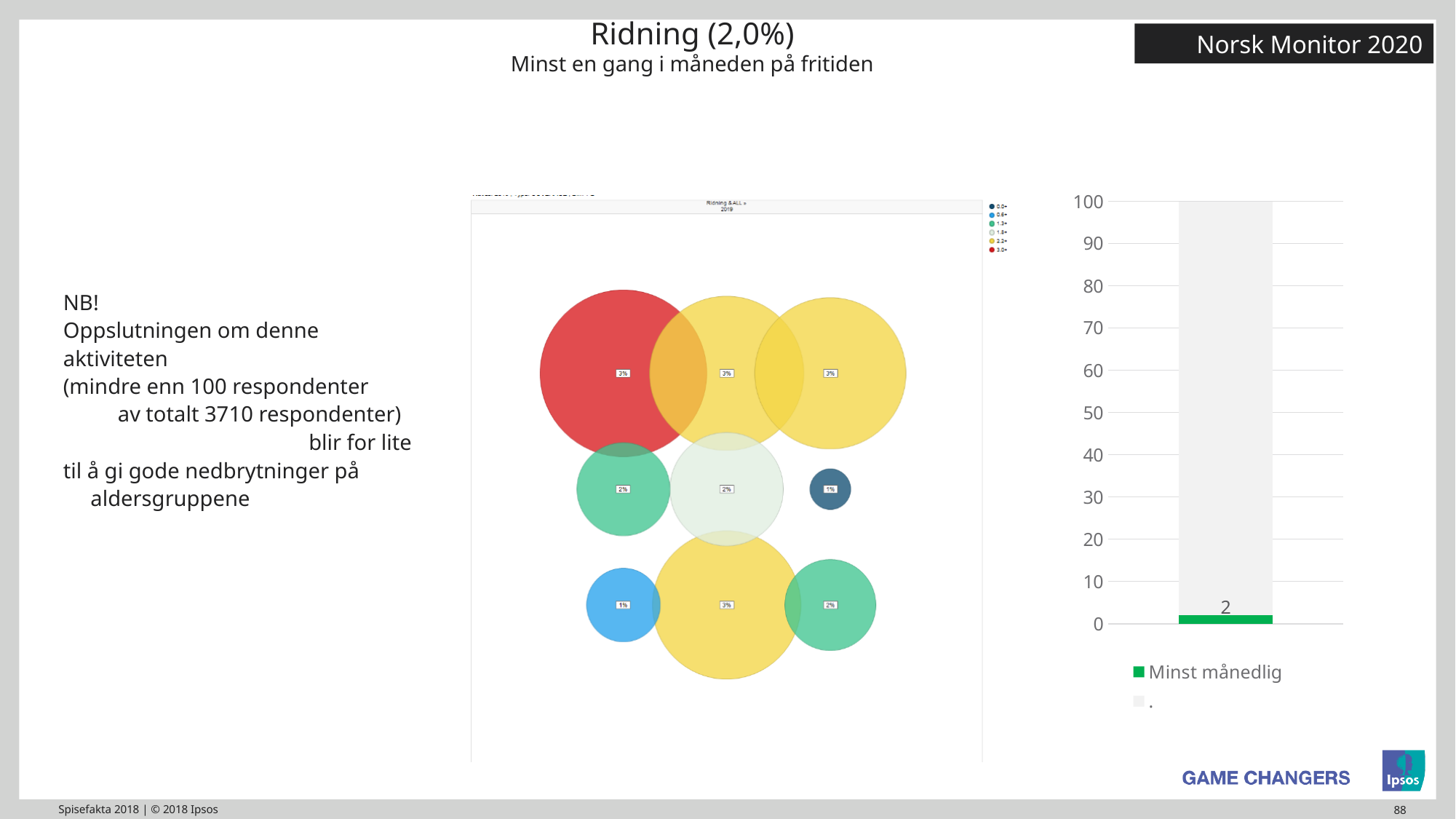
How many series does the legend of the bar chart on the right list? 2 On the bubble chart in the centre, what value is labelled on the red bubble? 3% On the bar chart on the right, what is the highest value shown on the vertical axis? 100 What kind of chart is shown in the centre of the slide? bubble chart On the bubble chart in the centre, what value is labelled on the light blue bubble? 1% How many bubbles are plotted on the bubble chart in the centre of the slide? 9 What kind of chart is shown on the right side of the slide? bar chart On the bar chart on the right, what colour is the 'Minst månedlig' series? green On the bubble chart in the centre, what value is labelled on the dark blue bubble? 1% On the bar chart on the right, what is the value of the 'Minst månedlig' series? 2 On the bar chart on the right, is the value for 'Minst månedlig' greater or less than 10? less